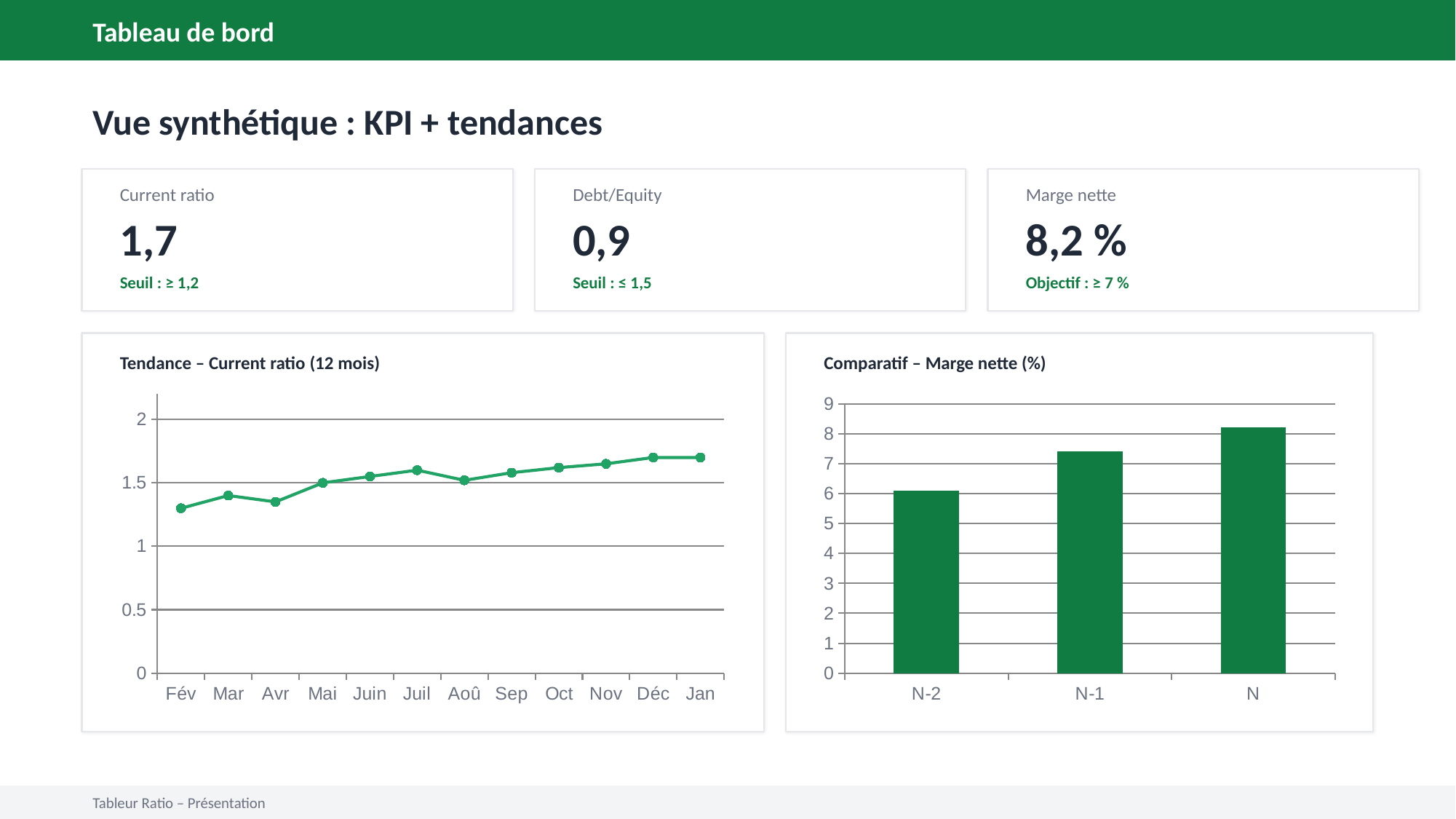
In the 'Comparatif – Marge nette (%)' chart, which category has the lowest value? N-2 In the 'Comparatif – Marge nette (%)' chart, how many bars are shown? 3 In the 'Tendance – Current ratio (12 mois)' chart, is the value for Fév greater or less than 1.5? less What kind of chart is the 'Comparatif – Marge nette (%)' chart? bar chart What kind of chart is the 'Tendance – Current ratio (12 mois)' chart? line chart In the 'Tendance – Current ratio (12 mois)' chart, which month has the lowest value? Fév In the 'Comparatif – Marge nette (%)' chart, is the value for N-2 greater or less than 7? less In the 'Tendance – Current ratio (12 mois)' chart, how many months are plotted along the x axis? 12 In the 'Comparatif – Marge nette (%)' chart, which is larger, N-1 or N-2? N-1 In the 'Tendance – Current ratio (12 mois)' chart, do the values generally rise or fall from Fév to Jan? rise In the 'Comparatif – Marge nette (%)' chart, which category has the highest value? N